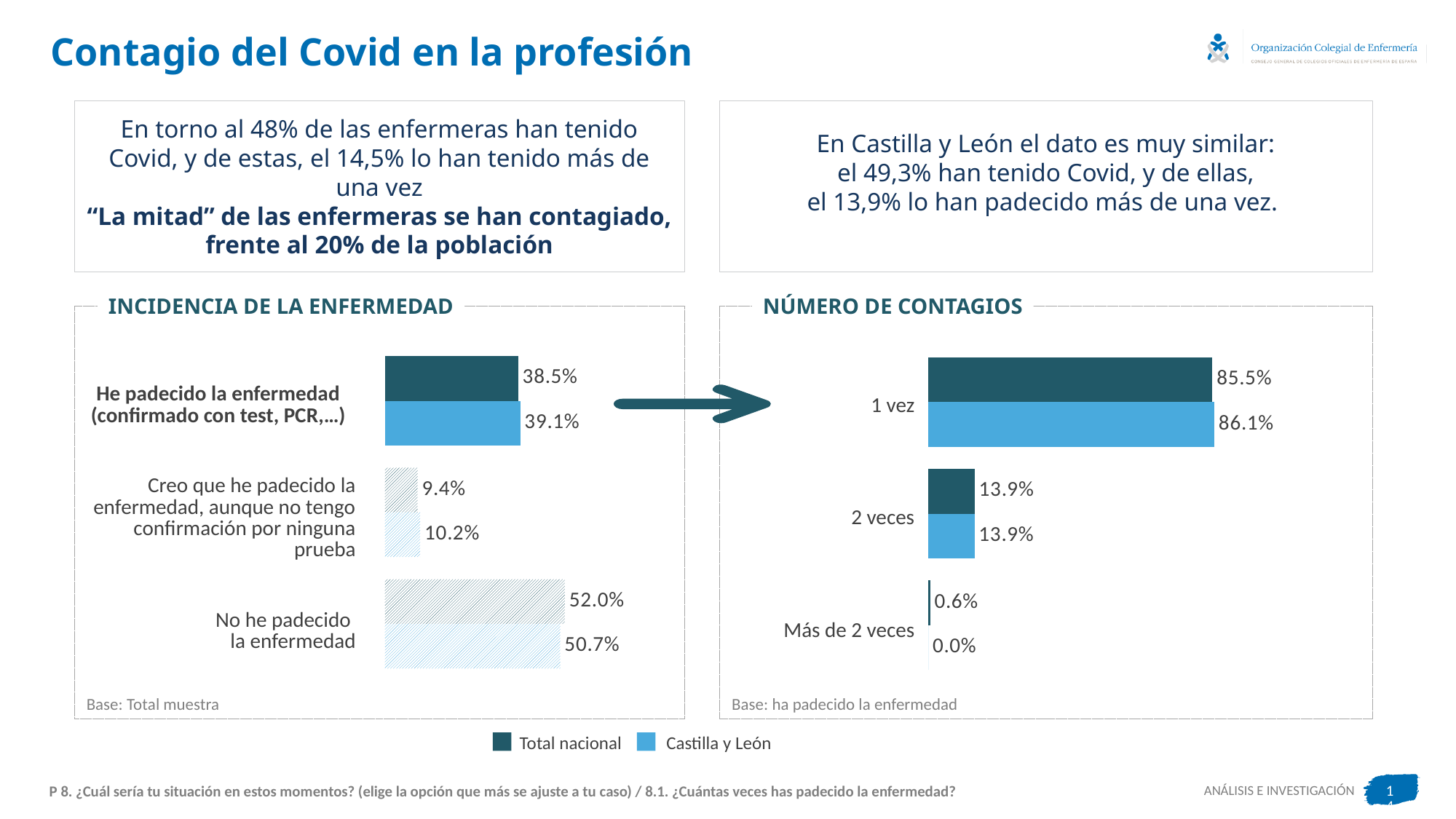
How many series does the legend list? 2 In the 'INCIDENCIA DE LA ENFERMEDAD' chart, which category has the lowest Castilla y León value? Creo que he padecido la enfermedad, aunque no tengo confirmación por ninguna prueba In the 'INCIDENCIA DE LA ENFERMEDAD' chart, what is the Castilla y León value for 'No he padecido la enfermedad'? 50.7% In the 'INCIDENCIA DE LA ENFERMEDAD' chart, what is the Total nacional value for 'He padecido la enfermedad (confirmado con test, PCR,...)'? 38.5% What is the base noted under the 'NÚMERO DE CONTAGIOS' chart? Base: ha padecido la enfermedad What kind of chart is 'NÚMERO DE CONTAGIOS'? Bar chart In the 'NÚMERO DE CONTAGIOS' chart, which is larger for '1 vez': Total nacional or Castilla y León? Castilla y León In the 'NÚMERO DE CONTAGIOS' chart, what is the Total nacional value for 'Más de 2 veces'? 0.6% In the 'NÚMERO DE CONTAGIOS' chart, what is the Castilla y León value for '1 vez'? 86.1% In the 'NÚMERO DE CONTAGIOS' chart, how many categories are shown? 3 In the 'INCIDENCIA DE LA ENFERMEDAD' chart, which category has the highest Total nacional value? No he padecido la enfermedad In the 'INCIDENCIA DE LA ENFERMEDAD' chart, what is the difference between the Total nacional and Castilla y León values for 'No he padecido la enfermedad'? 1.3%